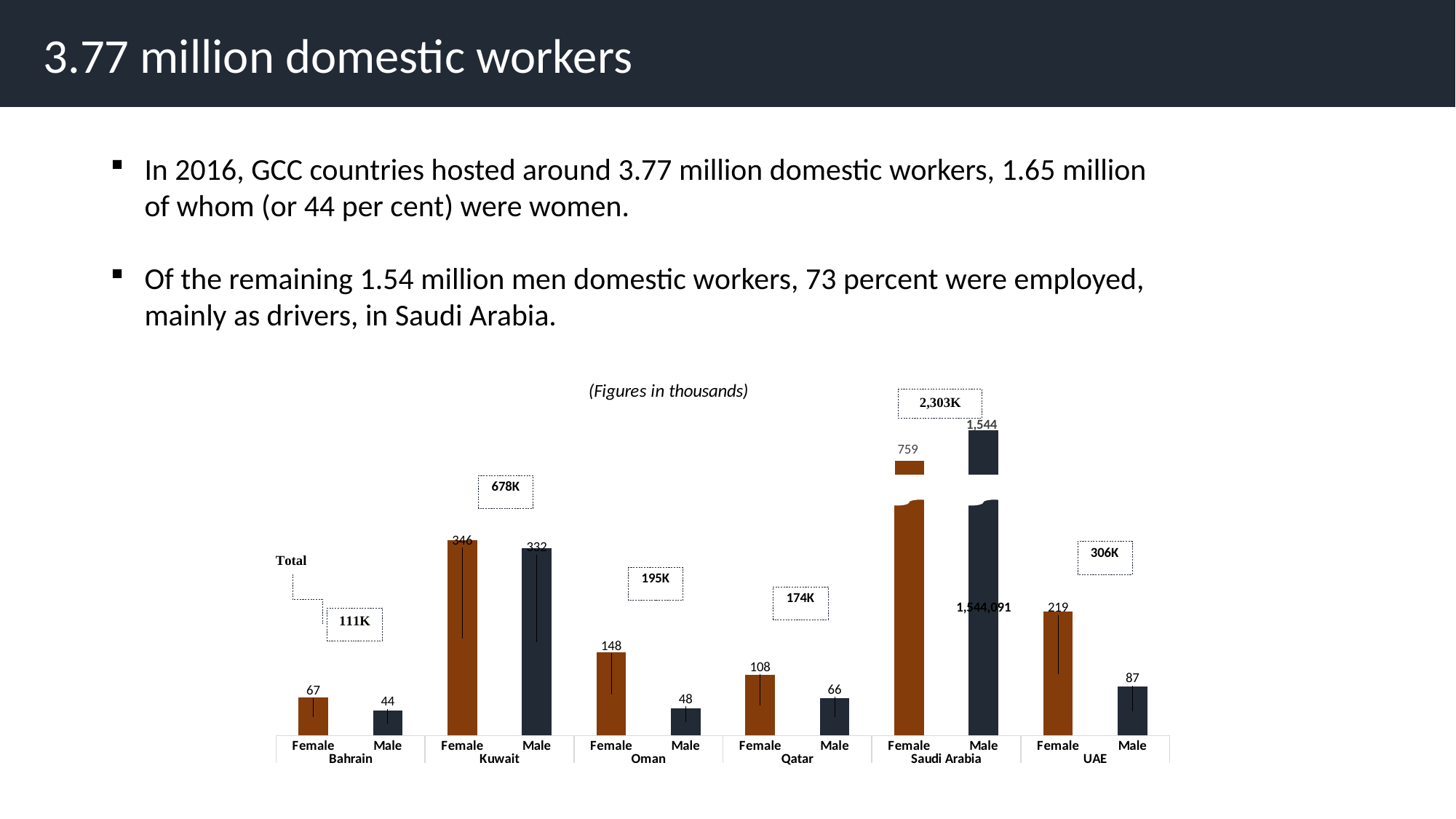
What is the difference between the female and male values for Oman? 100 Which is larger, the female value for Qatar or the male value for UAE? Female value for Qatar What is the value for female domestic workers in UAE? 219 In what units are the figures in the chart expressed? Thousands How many countries are shown on the x axis of the chart? 6 What is the difference between the male and female values for Saudi Arabia? 785 What is the value for male domestic workers in Saudi Arabia? 1,544 Which country has the lowest total of domestic workers? Bahrain Which country has the highest total of domestic workers? Saudi Arabia What is the total shown for Oman? 195K What is the value for female domestic workers in Kuwait? 346 What kind of chart is shown on the slide? Bar chart